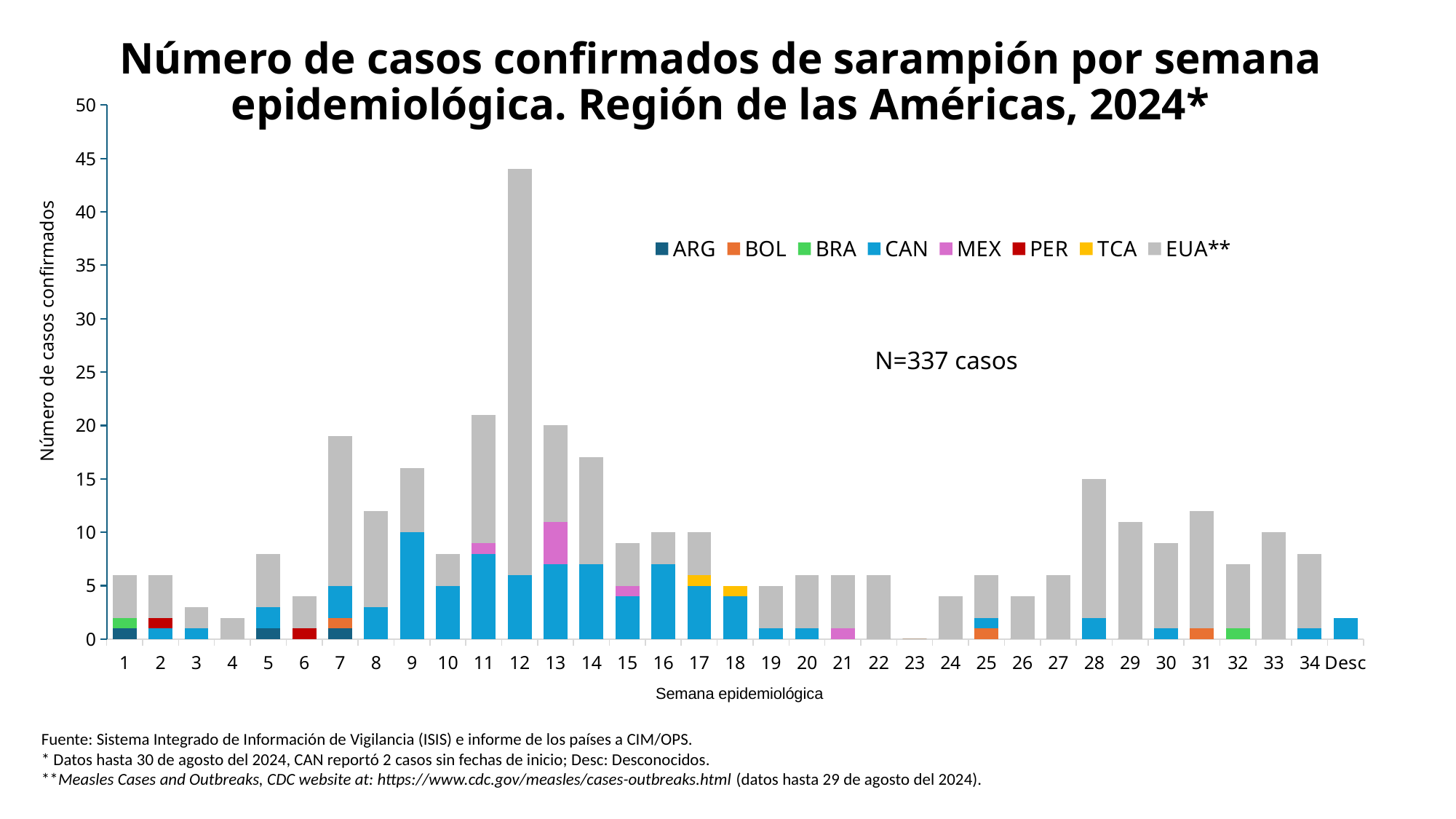
Is the total value for week 33 greater or less than 15? less What kind of chart is shown on the slide? Stacked bar chart How many series does the legend list? 8 Which has a larger total of confirmed cases, week 28 or week 33? Week 28 Is the total value for week 4 greater or less than 5? less Which has a larger total of confirmed cases, week 9 or week 10? Week 9 What total number of cases (N) is stated on the chart? N=337 casos Is the total value for week 28 greater or less than 10? greater How many categories are shown on the x axis (Semana epidemiológica)? 35 Which epidemiological week has the highest total number of confirmed cases? 12